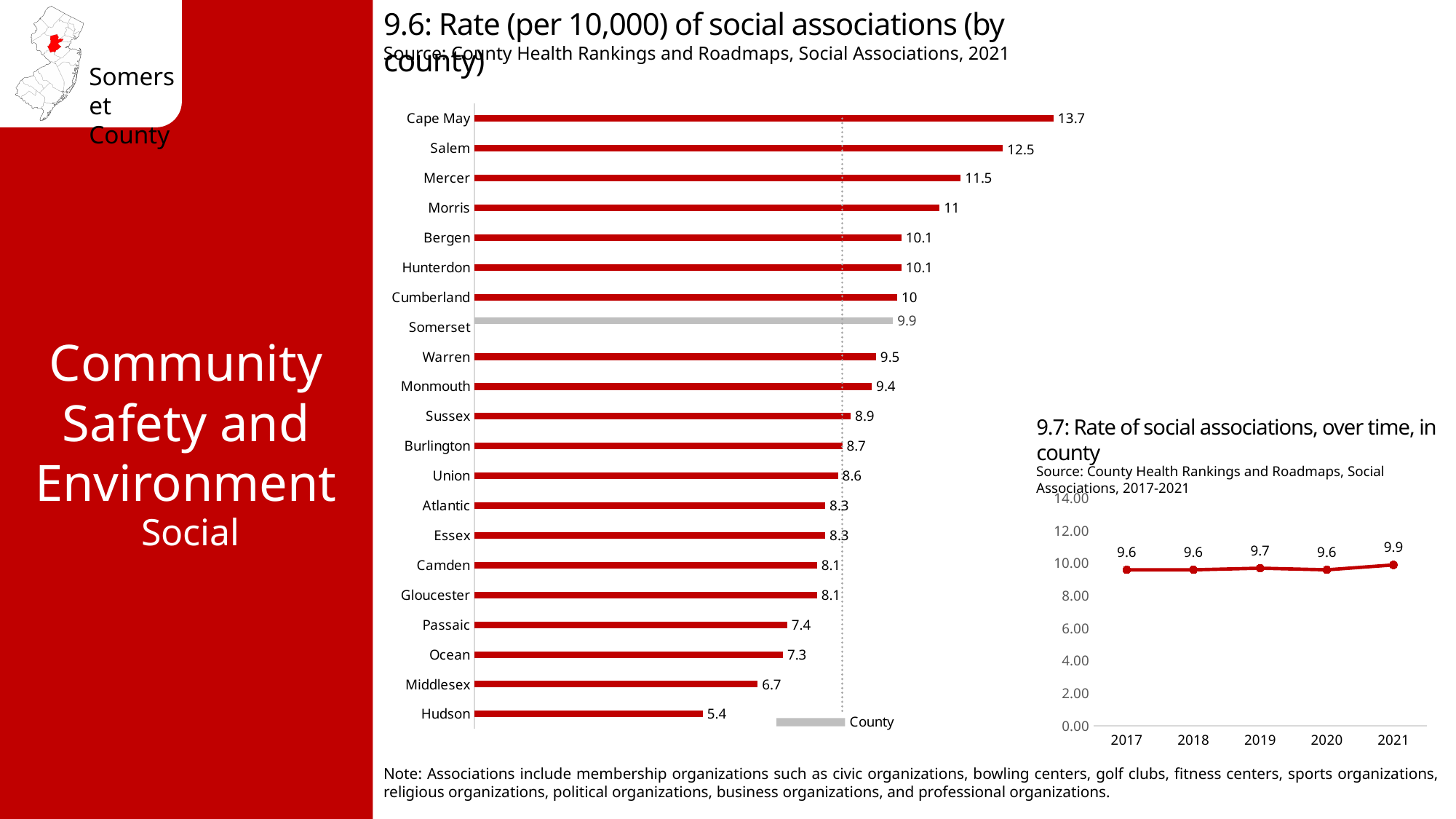
How many counties are shown in the chart '9.6: Rate (per 10,000) of social associations (by county)'? 21 In the chart '9.6: Rate (per 10,000) of social associations (by county)', which county has the highest rate? Cape May What kind of chart is '9.7: Rate of social associations, over time, in county'? Line chart In the chart '9.7: Rate of social associations, over time, in county', what is the value for 2019? 9.7 What kind of chart is '9.6: Rate (per 10,000) of social associations (by county)'? Bar chart In the chart '9.7: Rate of social associations, over time, in county', which year has the highest value? 2021 In the chart '9.6: Rate (per 10,000) of social associations (by county)', what is the difference between Cape May and Hudson? 8.3 In the chart '9.6: Rate (per 10,000) of social associations (by county)', what is the value for Somerset? 9.9 In the chart '9.7: Rate of social associations, over time, in county', what is the difference between the 2021 and 2017 values? 0.3 In the chart '9.6: Rate (per 10,000) of social associations (by county)', which is larger, the value for Salem or the value for Morris? Salem In the chart '9.6: Rate (per 10,000) of social associations (by county)', what is the value for Mercer? 11.5 In the chart '9.6: Rate (per 10,000) of social associations (by county)', which county has the lowest rate? Hudson